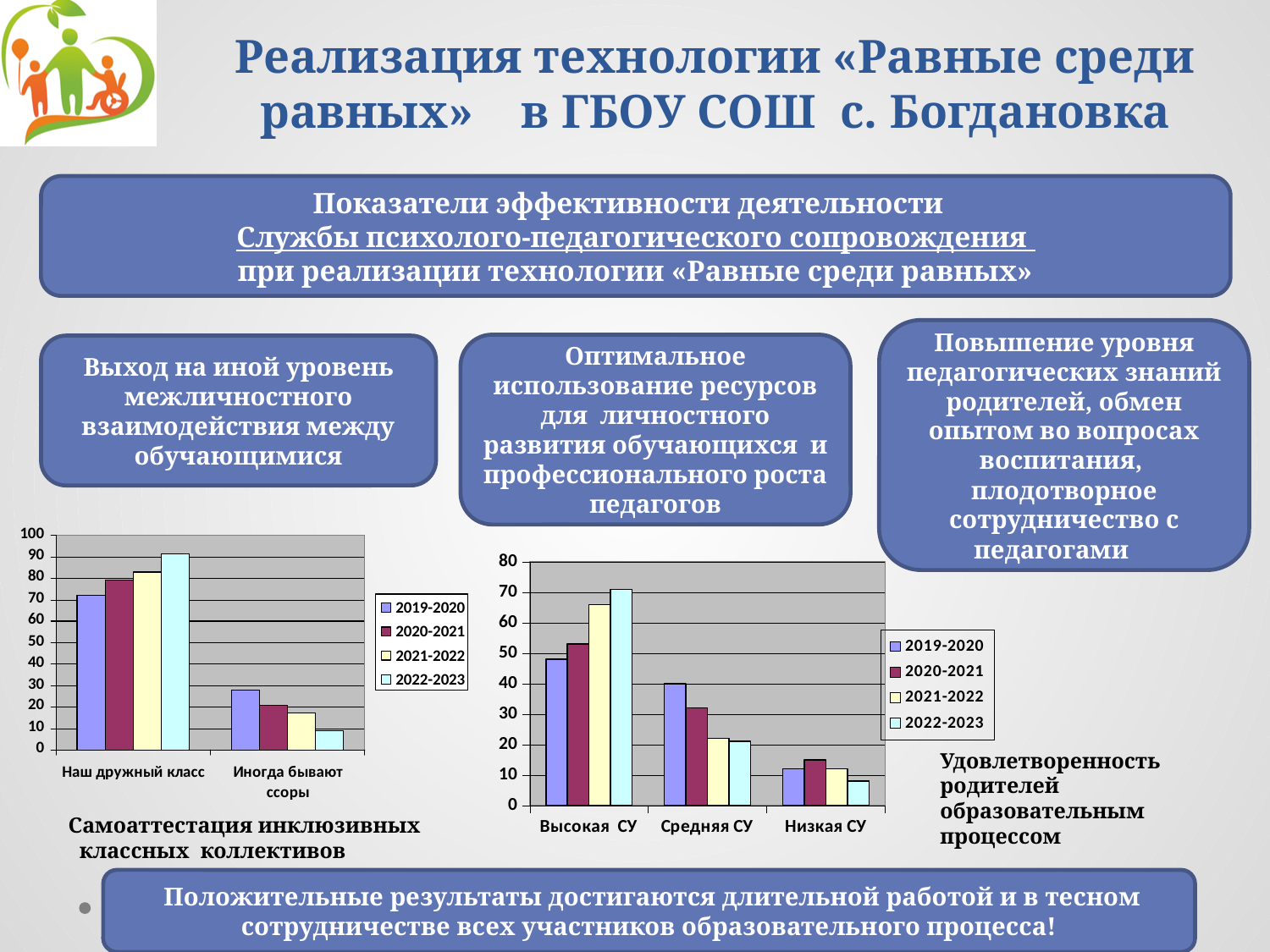
How many categories are shown on the x axis of the left chart (Самоаттестация инклюзивных классных коллективов)? 2 How many series does the legend of the right chart (Удовлетворенность родителей образовательным процессом) list? 4 In the left chart (Самоаттестация инклюзивных классных коллективов), is the 2022-2023 value for 'Наш дружный класс' greater or less than 90? greater What kind of chart is the left chart (Самоаттестация инклюзивных классных коллективов)? bar chart In the right chart (Удовлетворенность родителей образовательным процессом), which series has the highest value for 'Высокая СУ'? 2022-2023 In the left chart (Самоаттестация инклюзивных классных коллективов), which series has the highest value for 'Наш дружный класс'? 2022-2023 In the right chart (Удовлетворенность родителей образовательным процессом), which is larger for 'Средняя СУ': the 2019-2020 value or the 2020-2021 value? 2019-2020 In the left chart (Самоаттестация инклюзивных классных коллективов), which series has the lowest value for 'Иногда бывают ссоры'? 2022-2023 In the right chart (Удовлетворенность родителей образовательным процессом), do the 2022-2023 values rise or fall from 'Высокая СУ' to 'Низкая СУ'? fall How many categories are shown on the x axis of the right chart (Удовлетворенность родителей образовательным процессом)? 3